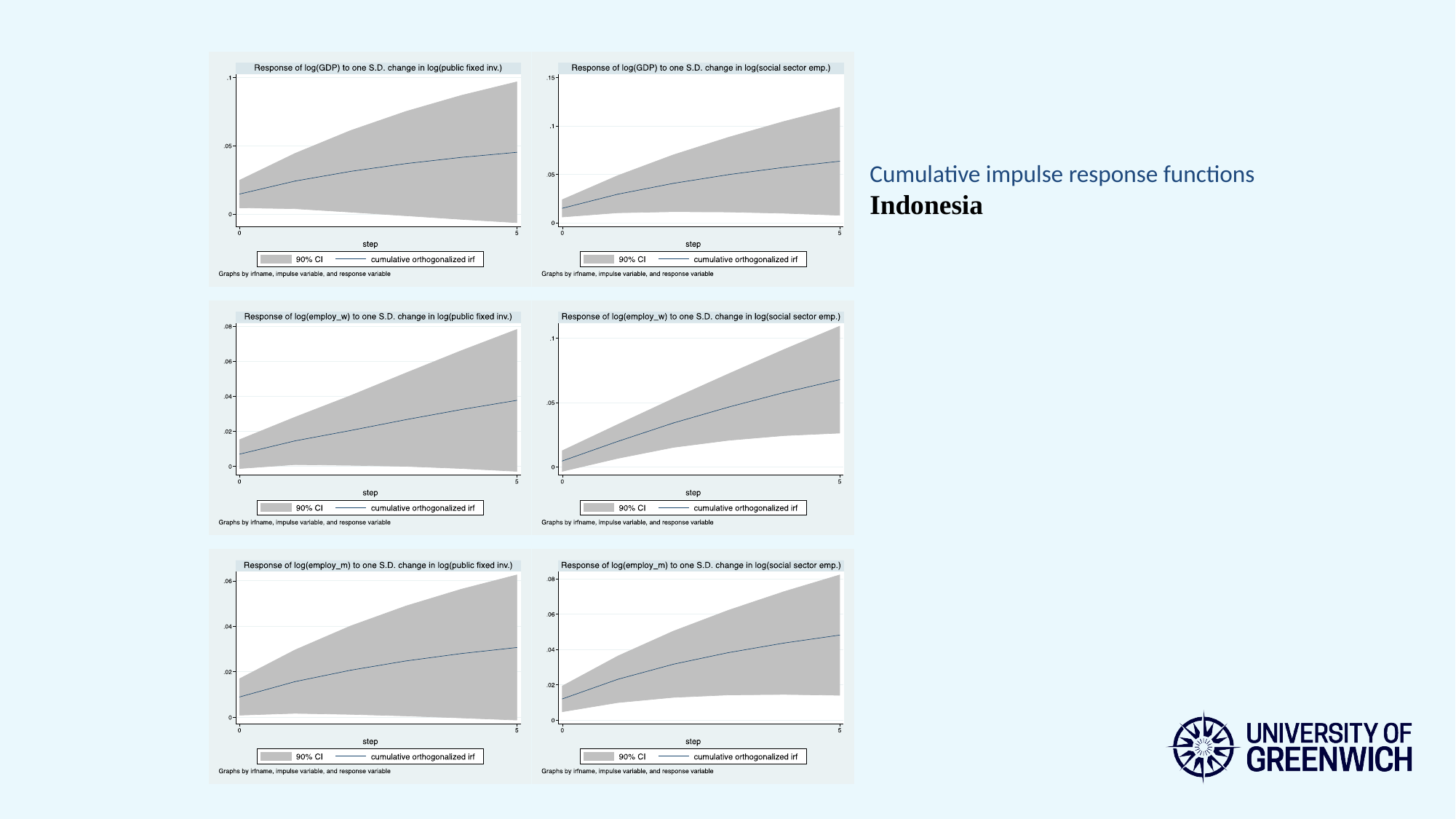
How many charts are shown on the slide? 6 In the top-right chart, 'Response of log(GDP) to one S.D. change in log(social sector emp.)', does the cumulative orthogonalized irf line rise or fall as step increases from 0 to 5? rise What kind of chart is the top-left chart, 'Response of log(GDP) to one S.D. change in log(public fixed inv.)'? line chart What is the label of the x axis on the middle-left chart, 'Response of log(employ_w) to one S.D. change in log(public fixed inv.)'? step In the bottom-left chart, 'Response of log(employ_m) to one S.D. change in log(public fixed inv.)', is the value of the cumulative orthogonalized irf at step 5 greater or less than .04? less How many entries does the legend of the top-left chart, 'Response of log(GDP) to one S.D. change in log(public fixed inv.)', list? 2 In the middle-left chart, 'Response of log(employ_w) to one S.D. change in log(public fixed inv.)', is the value of the cumulative orthogonalized irf at step 0 greater or less than .02? less In the bottom-left chart, 'Response of log(employ_m) to one S.D. change in log(public fixed inv.)', is the value of the cumulative orthogonalized irf at step 5 greater or less than .02? greater In the bottom-right chart, 'Response of log(employ_m) to one S.D. change in log(social sector emp.)', does the cumulative orthogonalized irf line rise or fall along the step axis? rise What does the grey shaded band in the top-right chart, 'Response of log(GDP) to one S.D. change in log(social sector emp.)', represent according to the legend? 90% CI